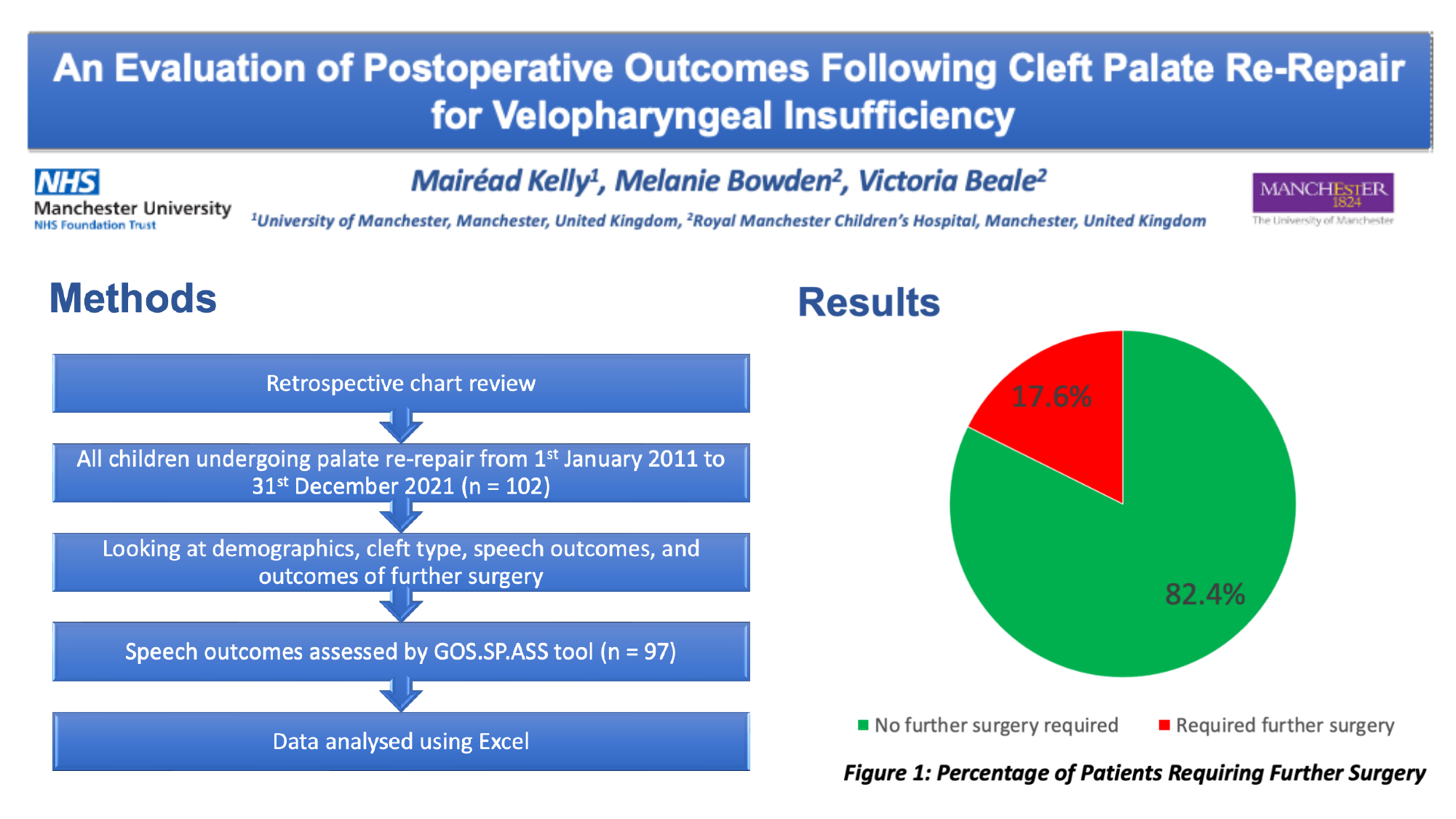
What colour is the 'Required further surgery' slice? Red Which category has the largest share of the pie? No further surgery required Which is larger: the share of patients who required further surgery or the share who did not? No further surgery required Which category has the smallest share of the pie? Required further surgery What percentage of patients required further surgery? 17.6% What percentage of patients required no further surgery? 82.4% What is the caption of the pie chart figure? Figure 1: Percentage of Patients Requiring Further Surgery What is the difference in percentage points between the 'No further surgery required' and 'Required further surgery' slices? 64.8 How many entries does the legend of the pie chart list? 2 What kind of chart is shown in the Results section? Pie chart How many slices does the pie chart have? 2